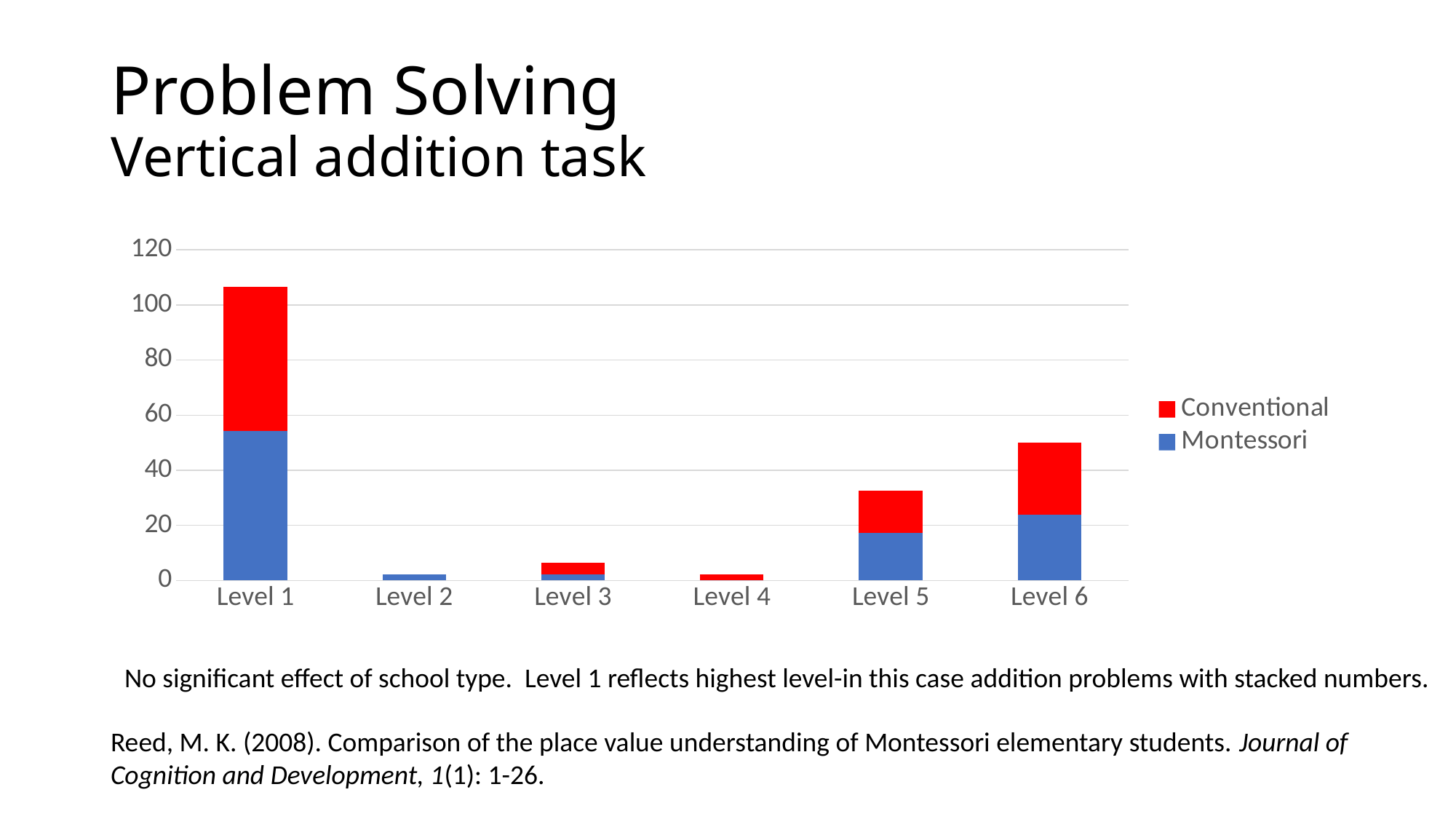
Is the total stacked value for Level 6 greater or less than 60? less What are the two series named in the legend? Conventional and Montessori How many levels (categories) are shown on the x axis? 6 Which level has the tallest stacked bar overall? Level 1 Is the Montessori value for Level 1 greater or less than 40? greater How many series does the legend list? 2 Which colour represents the Conventional series in the legend? Red Which has the larger total stacked bar, Level 5 or Level 6? Level 6 Which has the larger Montessori value, Level 1 or Level 6? Level 1 Is the total stacked value for Level 1 greater or less than 100? greater What kind of chart is shown on the slide? Stacked bar chart